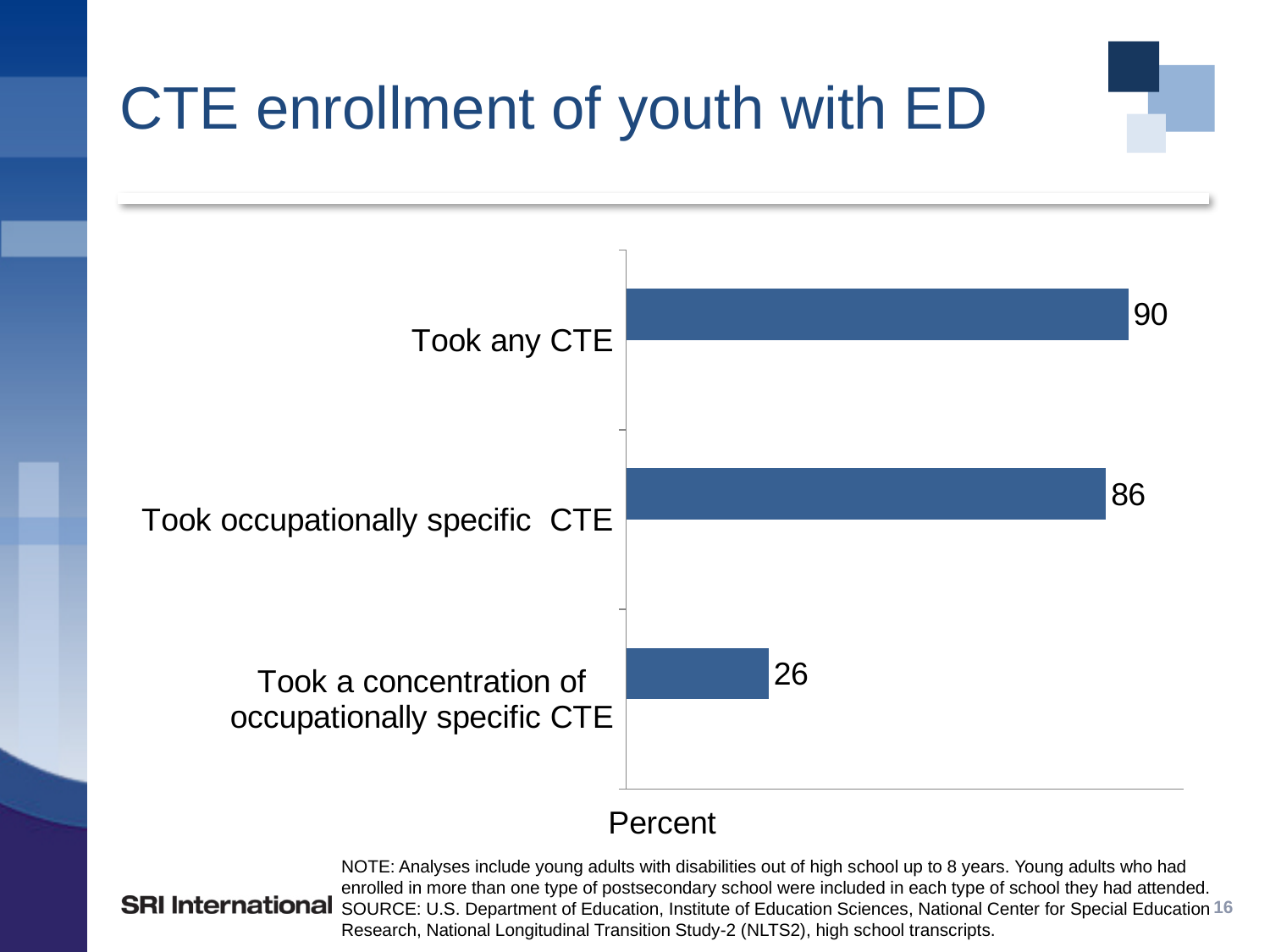
What is the value for "Took occupationally specific CTE"? 86 What is the difference between the values for "Took occupationally specific CTE" and "Took a concentration of occupationally specific CTE"? 60 Which is larger: the value for "Took any CTE" or the value for "Took a concentration of occupationally specific CTE"? Took any CTE What is the difference between the values for "Took any CTE" and "Took occupationally specific CTE"? 4 Which category has the highest value? Took any CTE Which category has the lowest value? Took a concentration of occupationally specific CTE What is the label on the horizontal axis of the chart? Percent What is the value for "Took a concentration of occupationally specific CTE"? 26 What is the value for "Took any CTE"? 90 What kind of chart is shown on the slide? Bar chart How many categories are shown in the chart? 3 What is the title of the chart? CTE enrollment of youth with ED